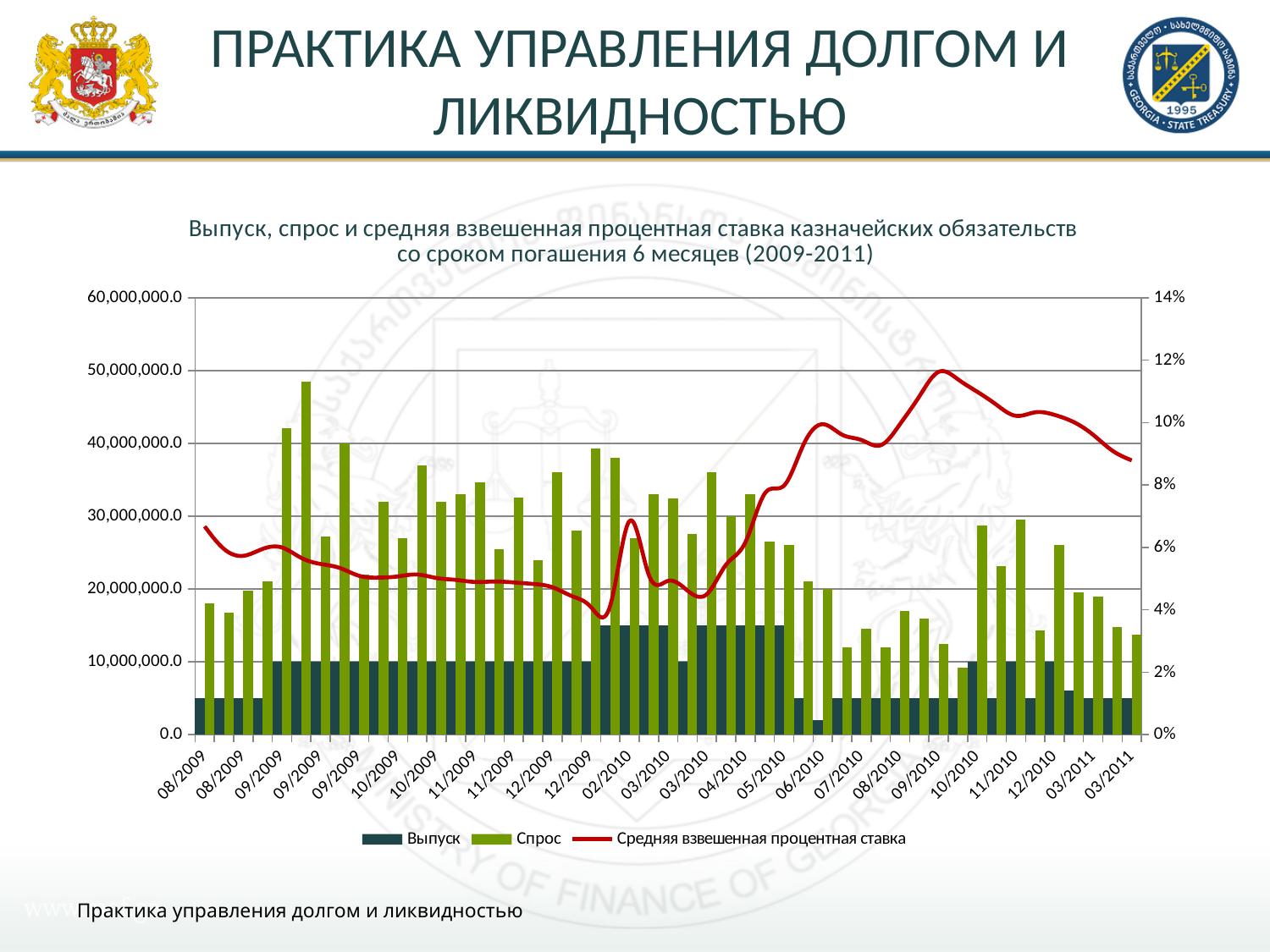
Does the Средняя взвешенная процентная ставка line rise or fall between 06/2010 and 09/2010? rise Does the Средняя взвешенная процентная ставка line rise or fall between 10/2010 and 03/2011? fall Is the tallest Спрос bar greater or less than 40,000,000.0? greater What kind of chart is shown on the slide? A bar chart combined with a line Which series is plotted as a line rather than bars? Средняя взвешенная процентная ставка What is the highest value shown on the right-hand percentage axis? 14% Around which month label does the tallest Спрос bar appear? 09/2009 At the tallest Спрос bar, which is larger: Спрос or Выпуск? Спрос Is the highest Выпуск bar greater or less than 20,000,000.0? less How many series does the legend list? 3 Is the peak of the Средняя взвешенная процентная ставка line greater or less than 10%? greater